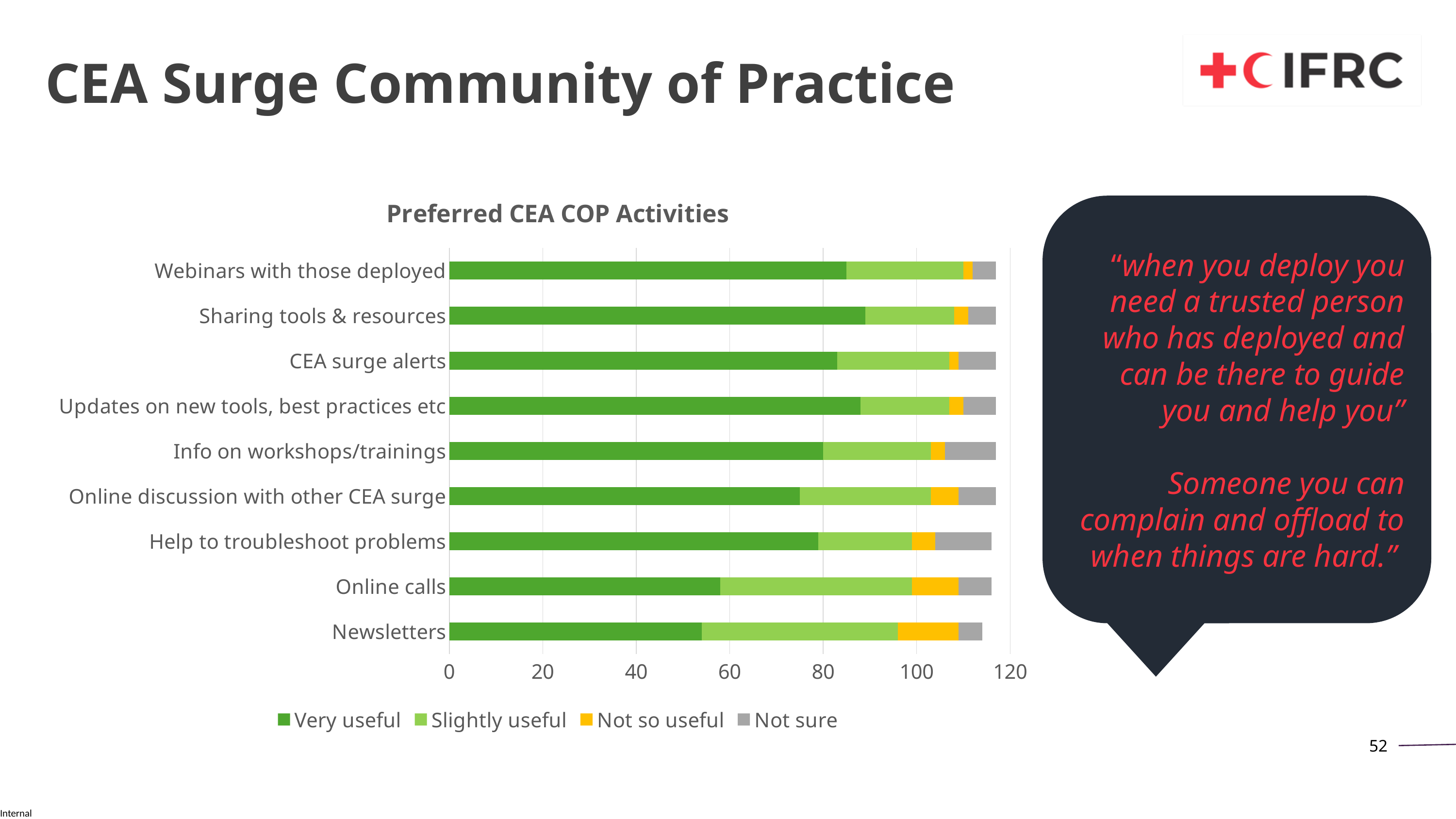
Which legend entry is shown in yellow? Not so useful How many activities (categories) are plotted in the chart? 9 What is the title of the chart? Preferred CEA COP Activities What type of chart is shown on the slide? bar chart Is the 'Very useful' value for Online discussion with other CEA surge greater or less than 80? less Which activity has the smallest 'Very useful' segment? Newsletters How many series does the legend list? 4 Which has a larger 'Slightly useful' segment: Newsletters or Webinars with those deployed? Newsletters Is the 'Very useful' value for Webinars with those deployed greater or less than 80? greater Is the 'Very useful' value for Newsletters greater or less than 60? less Which has a larger 'Very useful' segment: Webinars with those deployed or Online calls? Webinars with those deployed Which activity has the largest 'Not so useful' segment? Newsletters